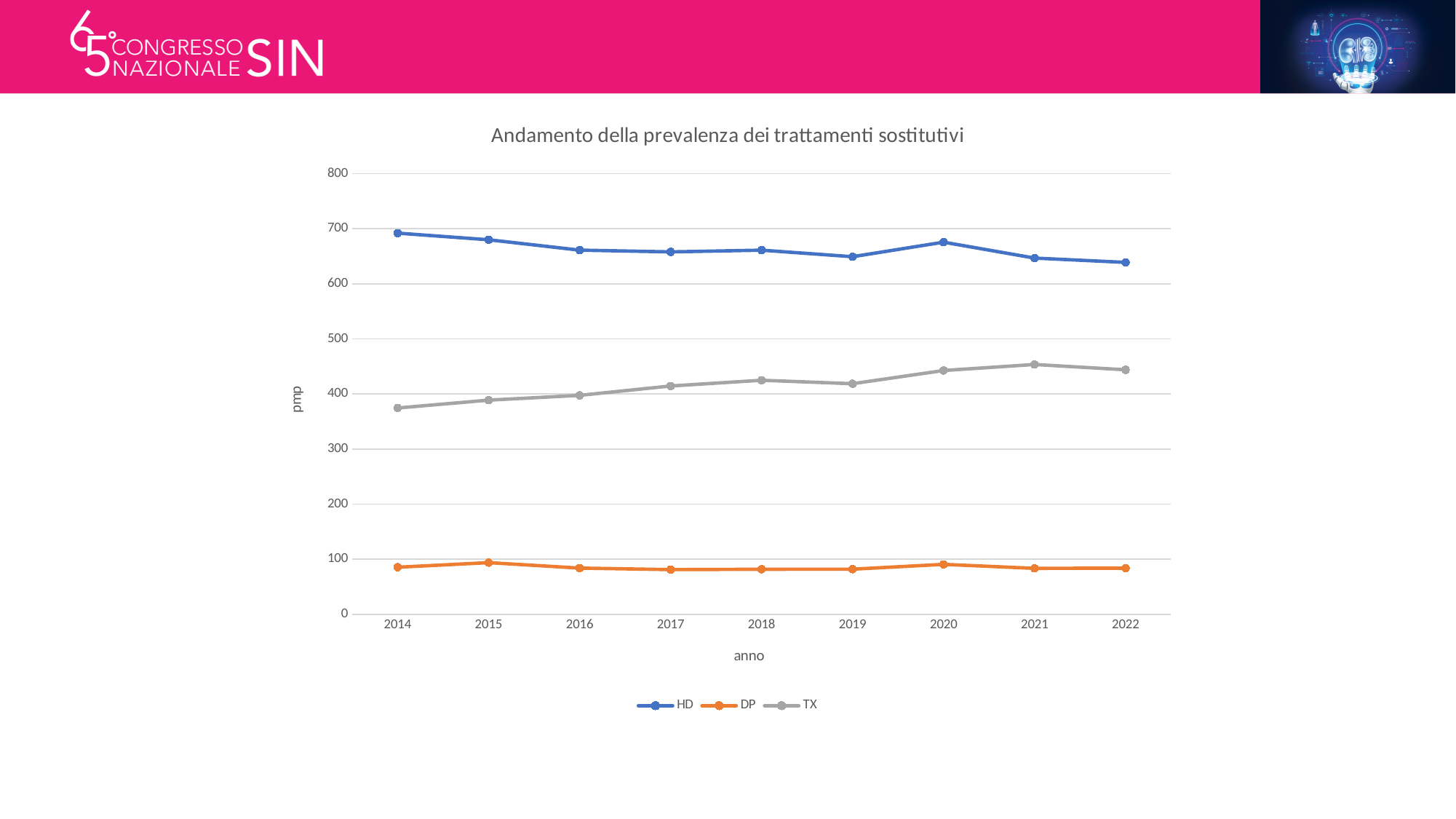
In 2022, which is larger, the value for HD or the value for TX? HD How many series does the legend list? 3 Does the TX series generally rise or fall from 2014 to 2022? rise What is the title of the chart? Andamento della prevalenza dei trattamenti sostitutivi What is the label of the y axis? pmp How many years are plotted along the x axis? 9 Is the value for TX in 2014 greater or less than 400? less Which series has the lowest values across all years? DP Which series has the highest values across all years? HD Does the HD series generally rise or fall from 2014 to 2022? fall What kind of chart is shown on the slide? line chart Is the value for HD in 2014 greater or less than 600? greater